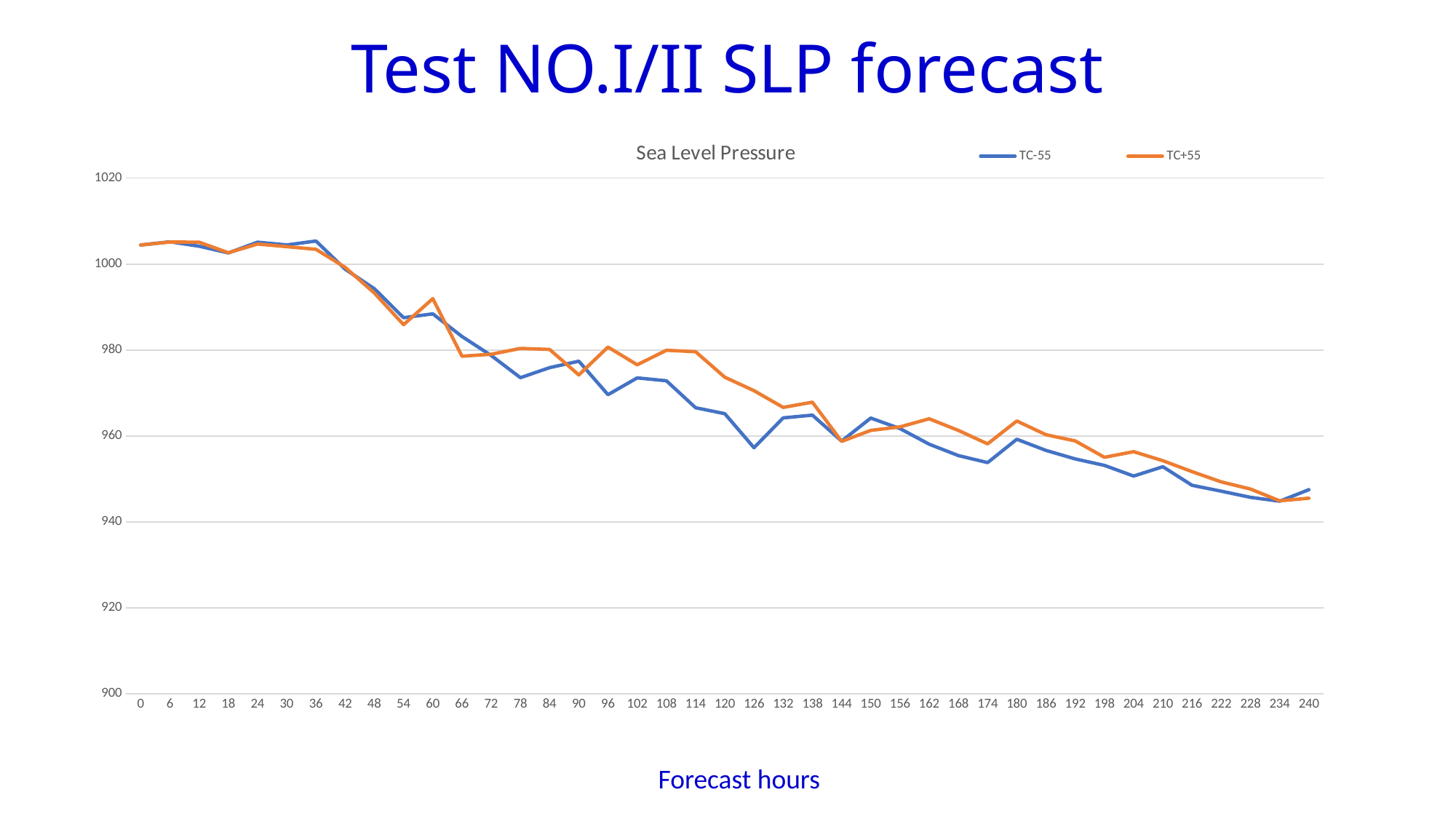
Is the TC+55 value at forecast hour 126 greater or less than 960? greater Is the TC-55 value at forecast hour 240 greater or less than 960? less Is the TC-55 value at forecast hour 126 greater or less than 960? less What is the title shown above the chart's plot area? Sea Level Pressure At forecast hour 96, which series has the higher value, TC-55 or TC+55? TC+55 How many forecast-hour points are marked along the x axis? 41 At forecast hour 126, which series has the higher value, TC-55 or TC+55? TC+55 Do the sea level pressure values generally rise or fall as forecast hours increase? fall How many series does the legend list? 2 What kind of chart is shown on the slide? line chart